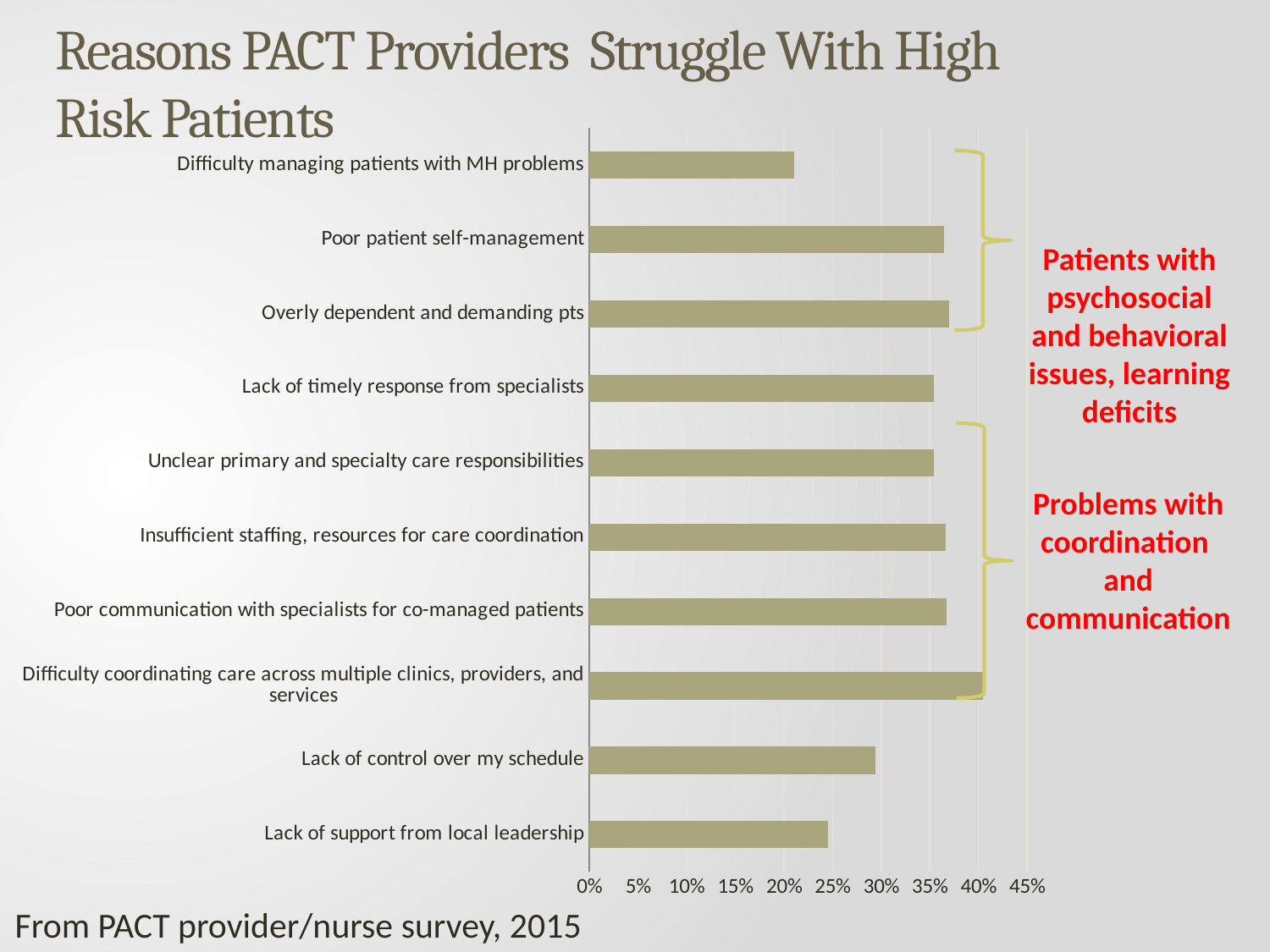
What kind of chart is shown on the slide? bar chart What is the title of the chart on the slide? Reasons PACT Providers Struggle With High Risk Patients Is the value for "Difficulty managing patients with MH problems" greater or less than 25%? less Which reason has the highest value in the chart? Difficulty coordinating care across multiple clinics, providers, and services Is the value for "Lack of control over my schedule" greater or less than 25%? greater Is the value for "Lack of support from local leadership" greater or less than 20%? greater Which reason has the lowest value in the chart? Difficulty managing patients with MH problems How many reasons (categories) are plotted in the chart? 10 Which is larger: the value for "Difficulty coordinating care across multiple clinics, providers, and services" or the value for "Lack of control over my schedule"? Difficulty coordinating care across multiple clinics, providers, and services Which is larger: the value for "Lack of control over my schedule" or the value for "Lack of support from local leadership"? Lack of control over my schedule